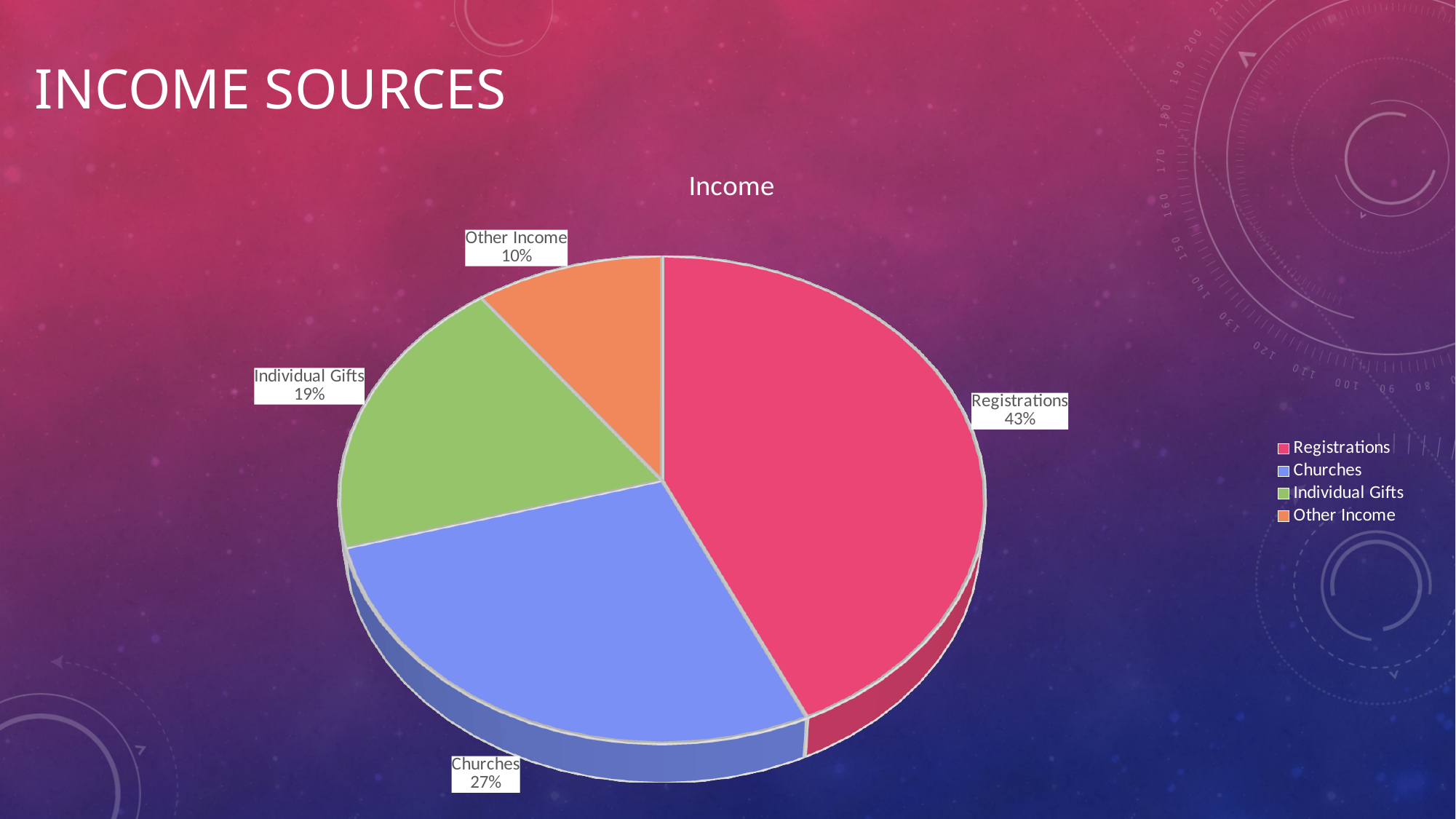
What share of income comes from Churches? 27% What is the difference in percentage points between Registrations and Churches? 16 Which income source has the largest share? Registrations What type of chart is shown on the slide? pie chart What share of income comes from Other Income? 10% Which is larger, the share for Individual Gifts or the share for Other Income? Individual Gifts What share of income comes from Registrations? 43% What is the title of the chart? Income What colour is the Churches slice? blue How many slices does the pie chart have? 4 Which income source has the smallest share? Other Income